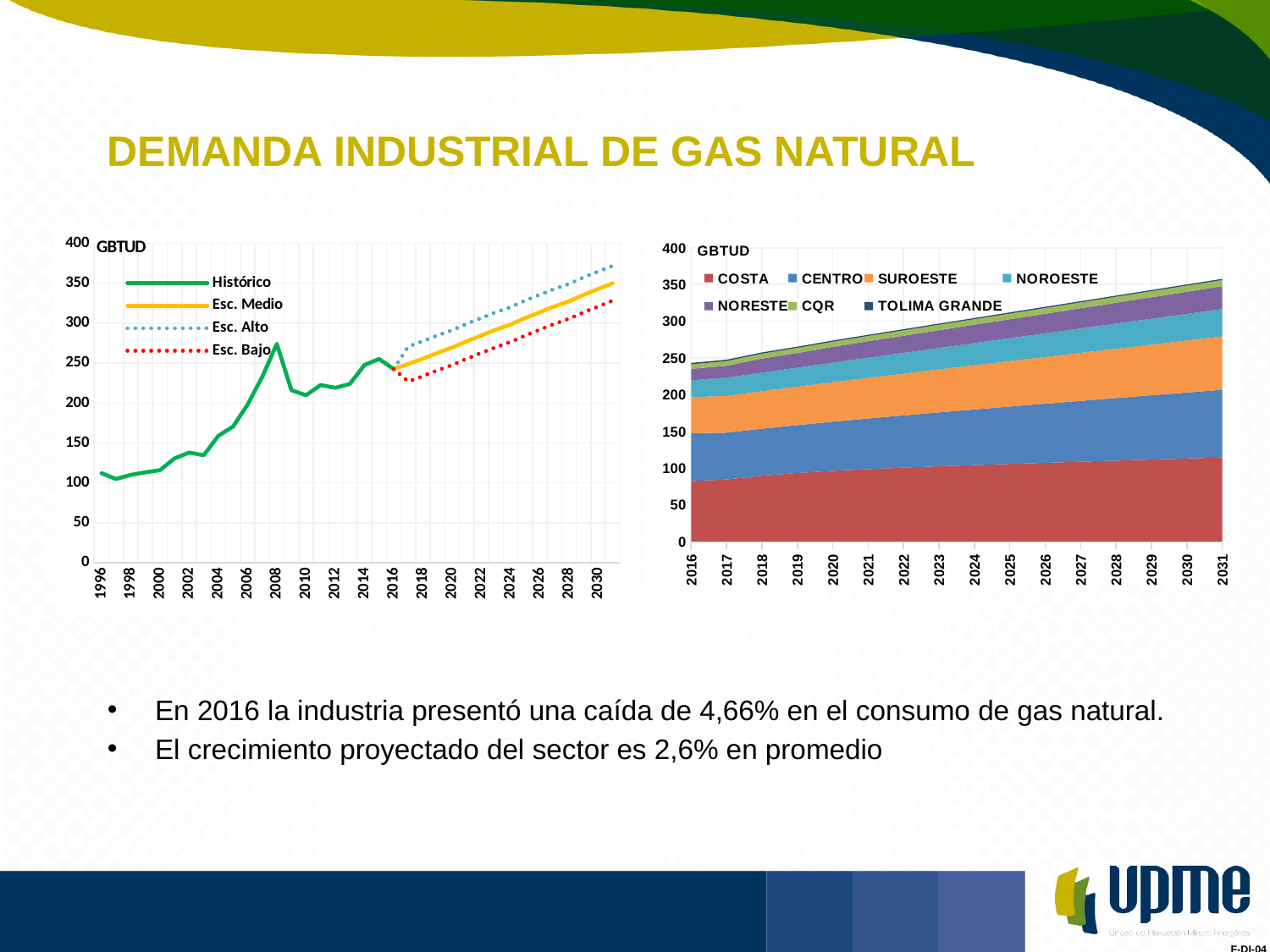
In the left chart, is the Esc. Alto value for 2030 greater or less than 350? greater In the right chart, is the total stacked value for 2031 greater or less than 300? greater In the right chart, does the total demand rise or fall from 2016 to 2031? Rises How many series does the legend of the right chart list? 7 What kind of chart is the left chart on the slide? Line chart What kind of chart is the right chart on the slide? Stacked area chart What unit is shown on the y axis of both charts? GBTUD In the right chart, which region forms the largest area (bottom layer) across all years? COSTA How many series does the legend of the left chart list? 4 In the left chart, which scenario series is lowest in 2030? Esc. Bajo In the left chart, which scenario series is highest in 2030? Esc. Alto In the left chart, is the Histórico value for 1996 greater or less than 150? less